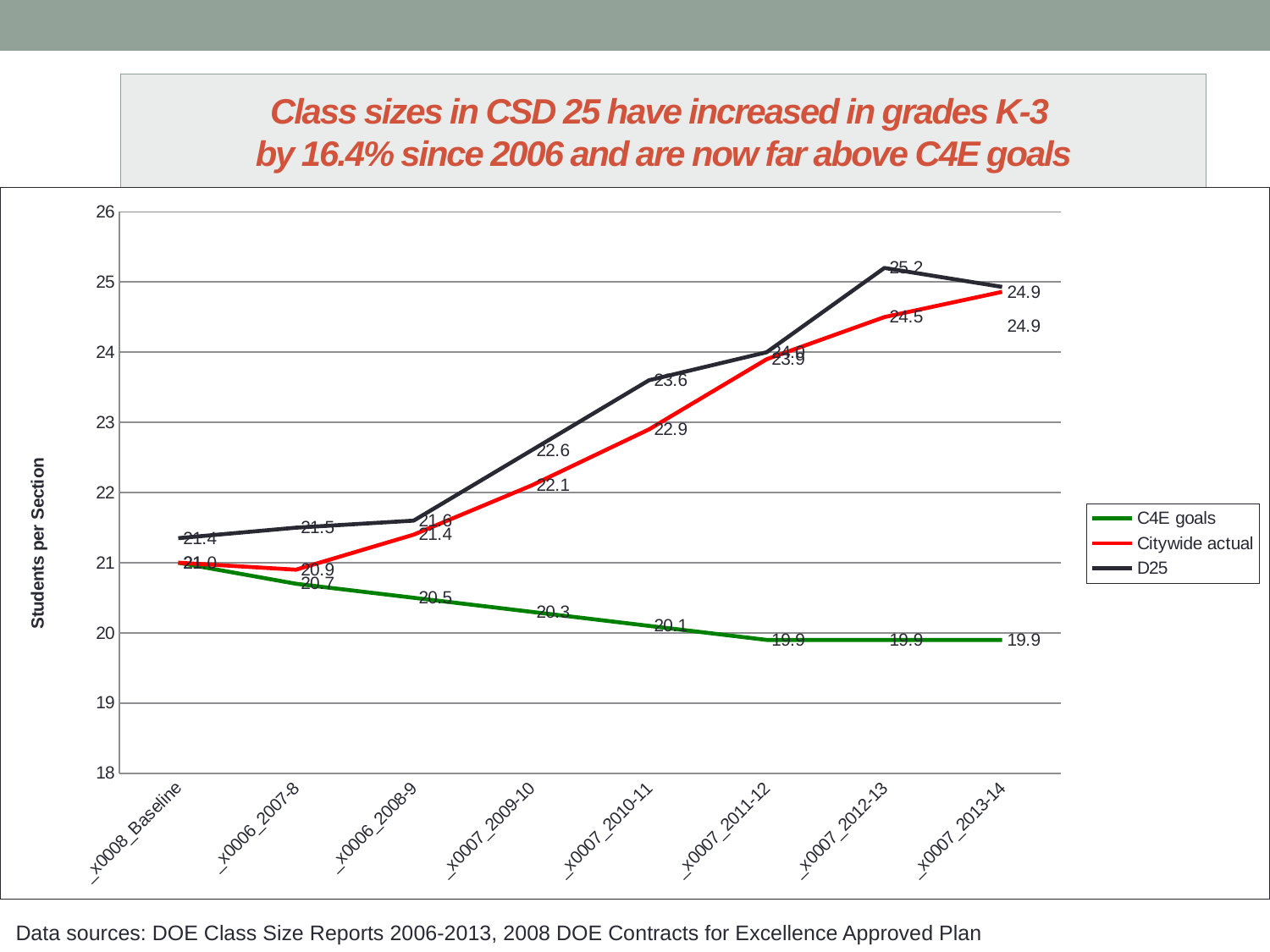
In 2010-11, which is larger: the D25 value or the Citywide actual value? D25 What kind of chart is shown on the slide? line chart What is the Citywide actual value for 2010-11? 22.9 What is the difference between the D25 value and the C4E goals value in 2012-13? 5.3 What is the C4E goals value for 2013-14? 19.9 How many points along the x axis does each line have? 8 Does the C4E goals line rise or fall from Baseline to 2013-14? fall In which year does the D25 line reach its highest value? 2012-13 What is the label on the y axis? Students per Section How many series does the legend list? 3 What is the D25 value for 2012-13? 25.2 In which year is the Citywide actual value lowest? 2007-8